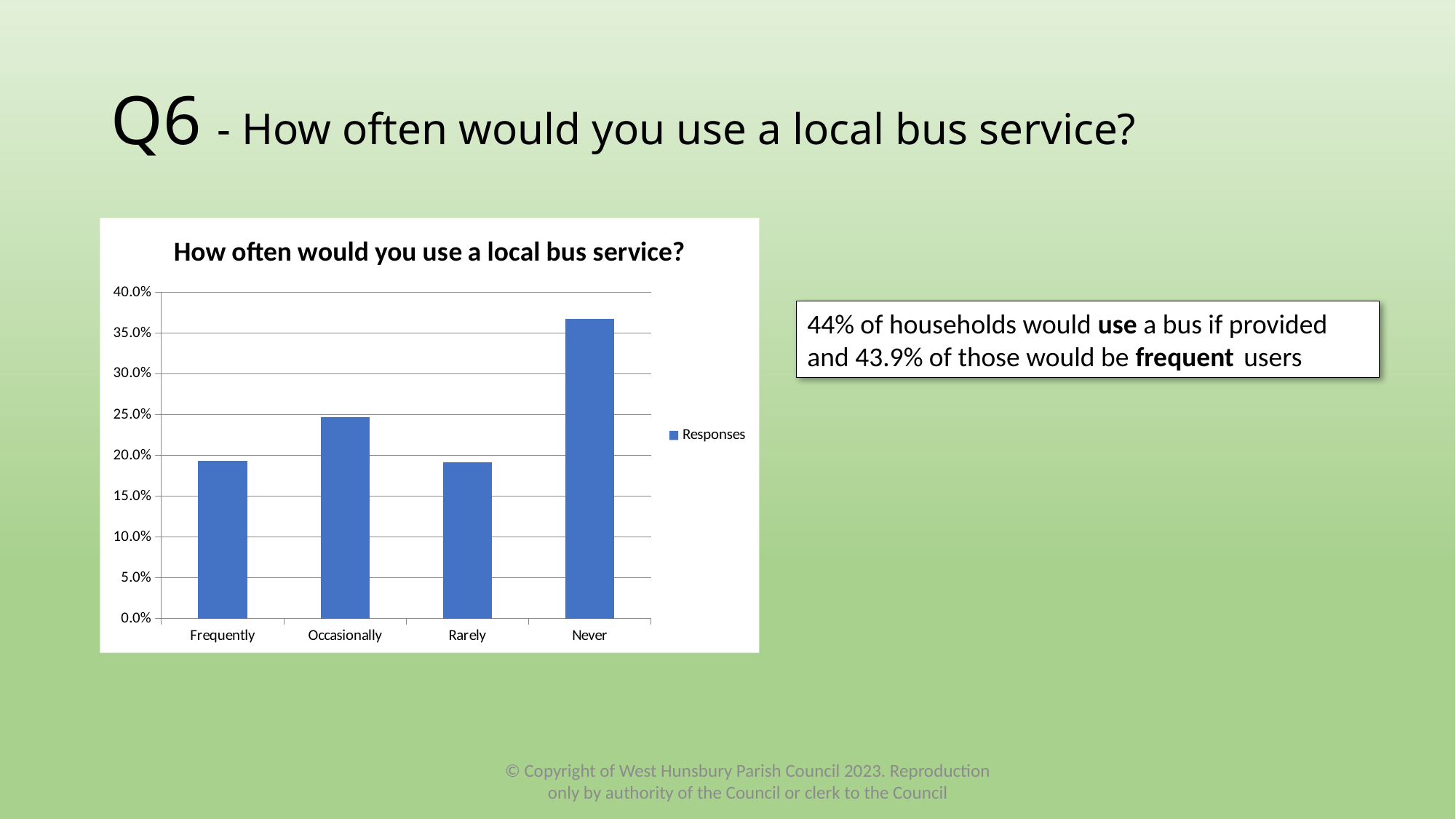
What is the name of the series shown in the chart legend? Responses What is the title of the chart? How often would you use a local bus service? Is the value for Never greater or less than 35.0%? greater Which category has the highest value in the chart? Never Is the value for Frequently greater or less than 20.0%? less What type of chart is shown on the slide? bar chart Is the value for Rarely greater or less than 15.0%? greater How many categories are shown on the x axis of the chart? 4 How many series does the chart legend list? 1 Which is larger, the value for Never or the value for Rarely? Never Which is larger, the value for Occasionally or the value for Frequently? Occasionally